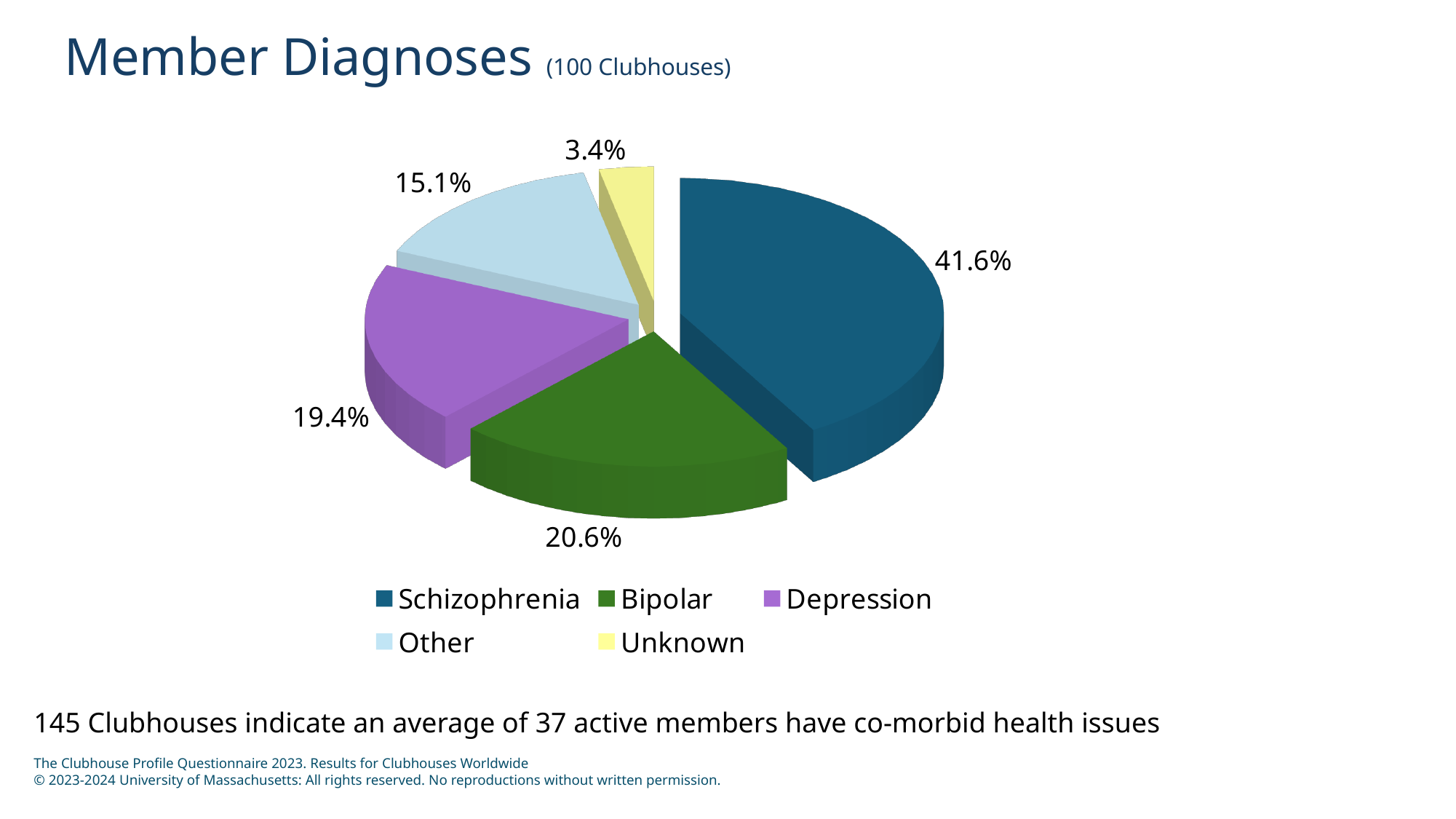
What kind of chart is shown on the slide? Pie chart What is the difference between the Schizophrenia share and the Bipolar share? 21.0% What is the value shown for Unknown? 3.4% Which is larger, the share for Depression or the share for Other? Depression How many slices does the pie chart have? 5 Which diagnosis has the largest share of the pie? Schizophrenia What is the value shown for Other? 15.1% What is the title of the chart? Member Diagnoses (100 Clubhouses) What is the value shown for Depression? 19.4% Which diagnosis has the smallest share of the pie? Unknown What is the value shown for Bipolar? 20.6% What share of the pie does Schizophrenia represent? 41.6%